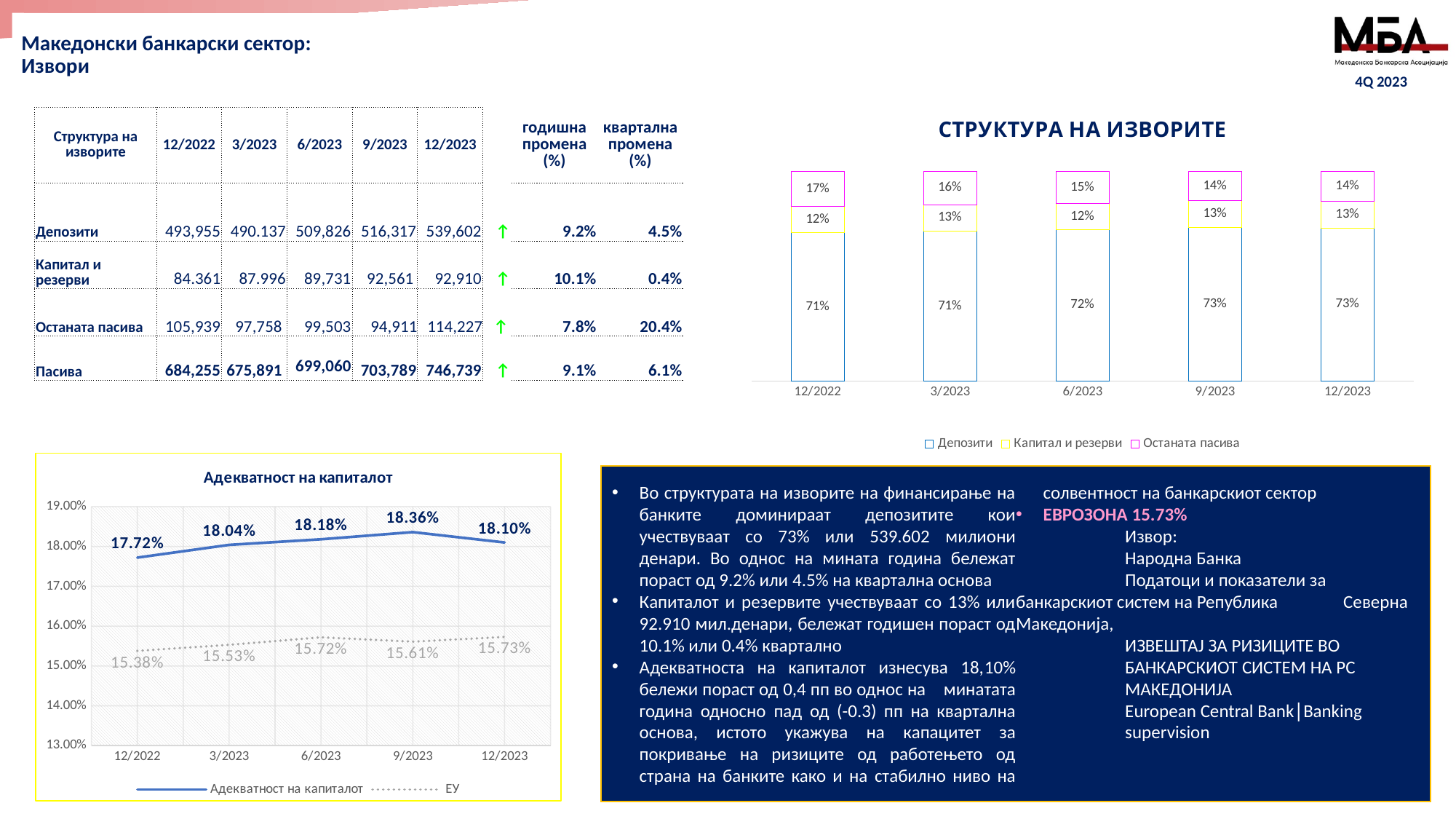
In the chart titled 'СТРУКТУРА НА ИЗВОРИТЕ', how many periods are shown on the x axis? 5 In the chart titled 'СТРУКТУРА НА ИЗВОРИТЕ', what kind of chart is it? Stacked bar chart In the chart titled 'СТРУКТУРА НА ИЗВОРИТЕ', what is the share of Капитал и резерви in 3/2023? 13% In the chart titled 'СТРУКТУРА НА ИЗВОРИТЕ', what is the share of Депозити in 12/2023? 73% In the chart titled 'СТРУКТУРА НА ИЗВОРИТЕ', how many series does the legend list? 3 In the chart titled 'СТРУКТУРА НА ИЗВОРИТЕ', does the share of Останата пасива rise or fall from 12/2022 to 12/2023? Fall In the chart titled 'Адекватност на капиталот', what is the value of ЕУ in 12/2023? 15.73% In the chart titled 'Адекватност на капиталот', what is the difference between Адекватност на капиталот and ЕУ in 12/2023? 2.37% In the chart titled 'Адекватност на капиталот', what is the value of Адекватност на капиталот in 9/2023? 18.36% In the chart titled 'Адекватност на капиталот', in which period is Адекватност на капиталот highest? 9/2023 In the chart titled 'СТРУКТУРА НА ИЗВОРИТЕ', what is the share of Останата пасива in 12/2022? 17% In the chart titled 'Адекватност на капиталот', in which period is Адекватност на капиталот lowest? 12/2022